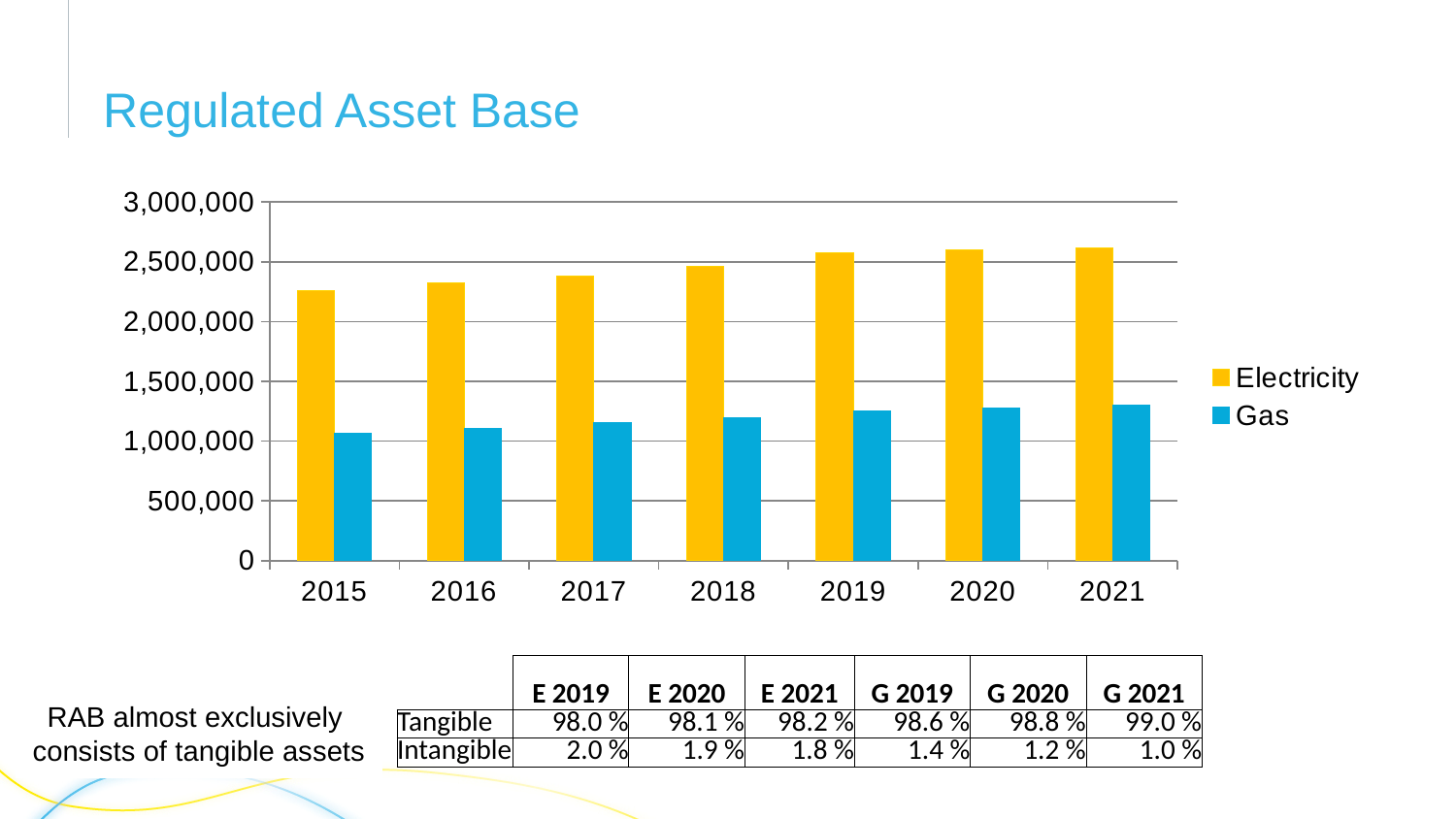
What kind of chart is shown on the slide? bar chart How many series does the chart legend list? 2 Is the Electricity value for 2017 greater or less than 2,500,000? less Do the Electricity values rise or fall from 2015 to 2021? rise Which year has the lowest Gas value? 2015 Is the Electricity value for 2015 greater or less than 2,000,000? greater Is the Electricity value for 2019 greater or less than 2,500,000? greater How many years are shown on the x axis of the chart? 7 Which year has the lowest Electricity value? 2015 Which is larger in 2018, the Electricity value or the Gas value? Electricity What colour are the Gas bars in the chart? blue